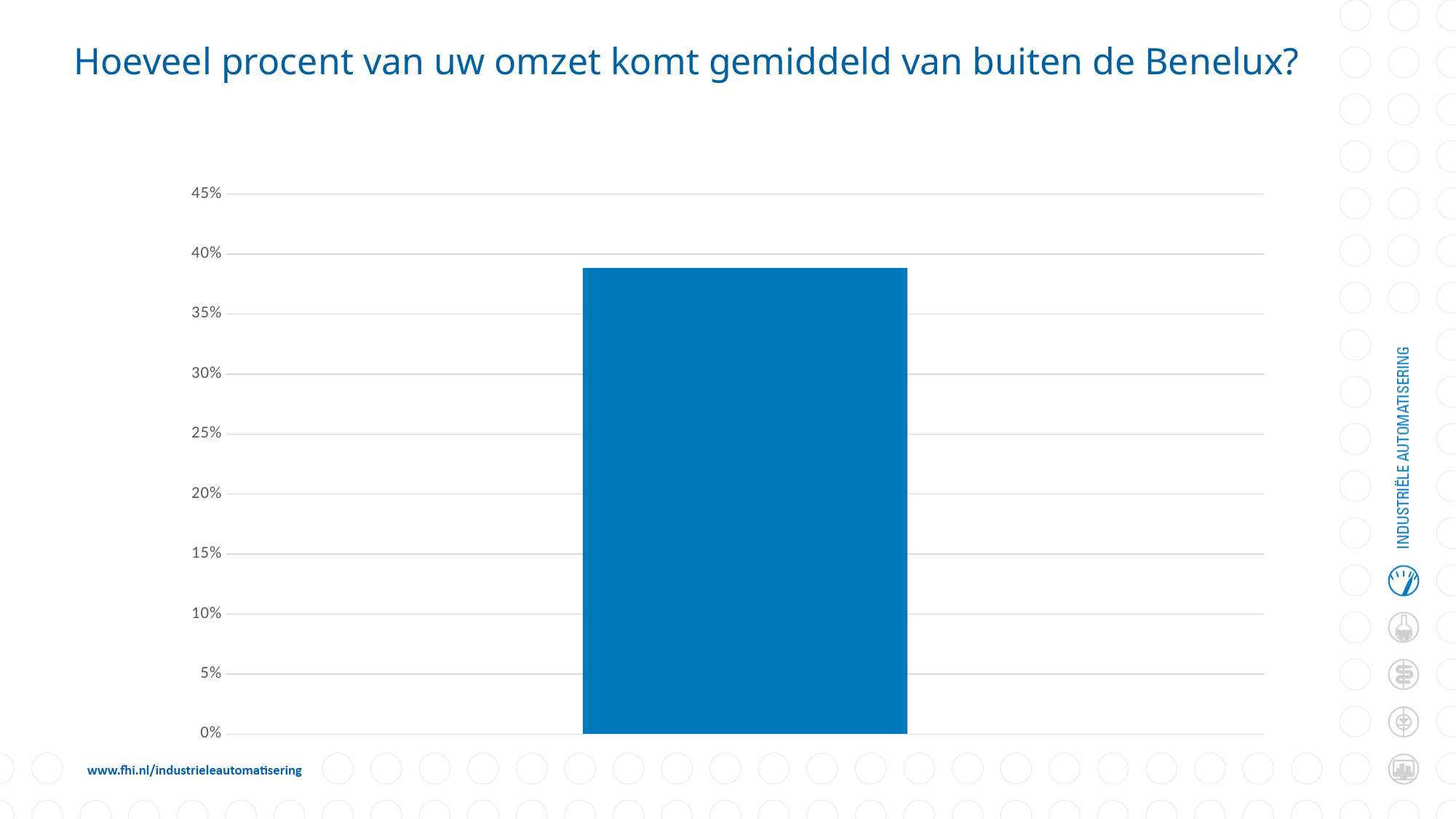
What is the highest value shown on the vertical axis of the chart? 45% Is the value of the bar greater or less than 40%? less What is the title of the chart on the slide? Hoeveel procent van uw omzet komt gemiddeld van buiten de Benelux? How many bars are plotted in the chart? 1 Is the value of the bar greater or less than 35%? greater Is the value of the bar greater or less than 20%? greater What kind of chart is shown on the slide? bar chart